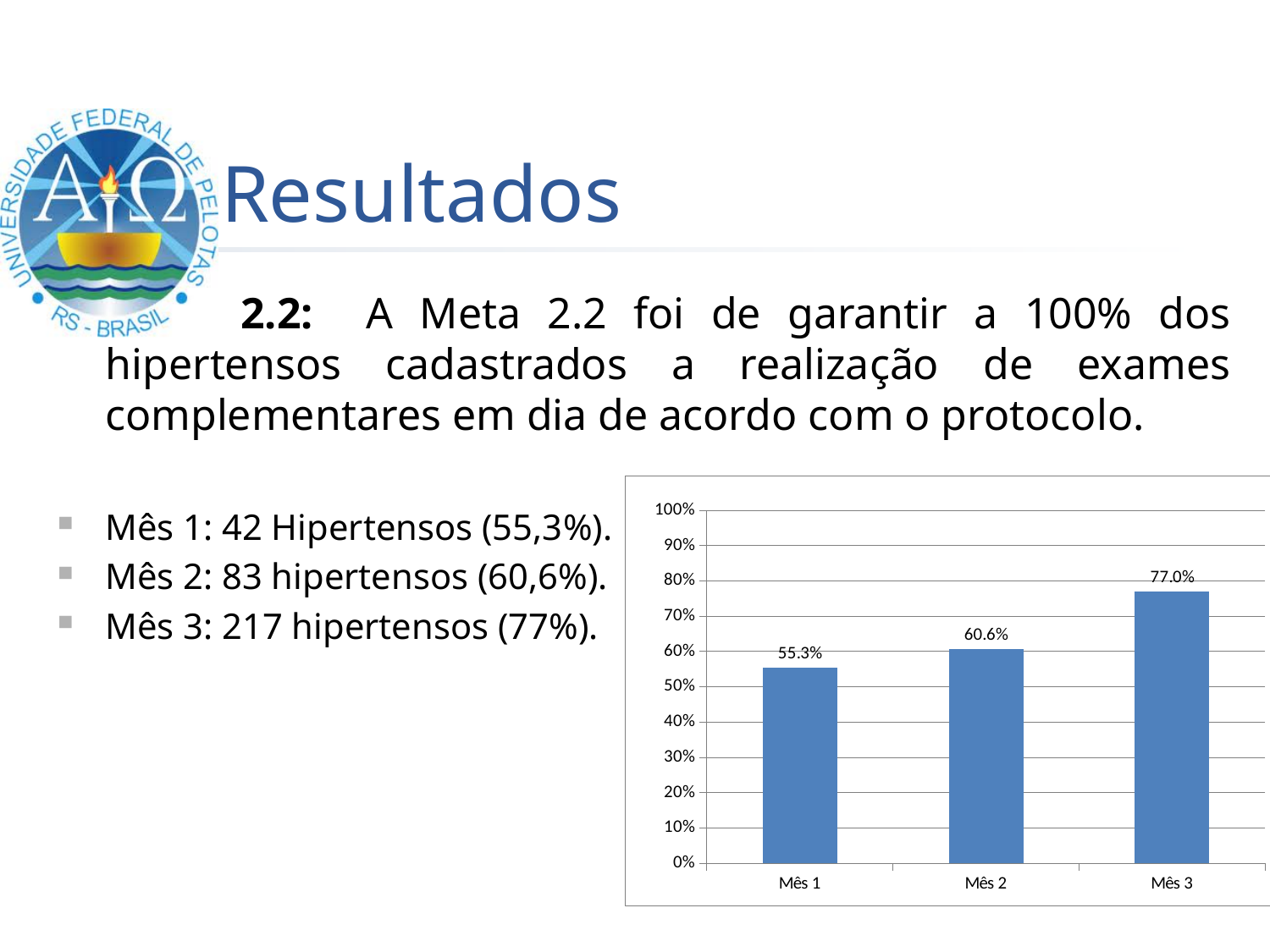
What is the value for Mês 1 in the chart? 55.3% What is the difference between the values for Mês 3 and Mês 1? 21.7% What is the value for Mês 3 in the chart? 77.0% Which month has the lowest value in the chart? Mês 1 Do the values rise or fall from Mês 1 to Mês 3? rise Which month has the highest value in the chart? Mês 3 How many categories are shown on the x axis of the chart? 3 Which is larger, the value for Mês 2 or the value for Mês 3? Mês 3 Is the value for Mês 3 greater or less than 70%? greater What is the difference between the values for Mês 2 and Mês 1? 5.3% What is the value for Mês 2 in the chart? 60.6% What kind of chart is shown on the slide? bar chart